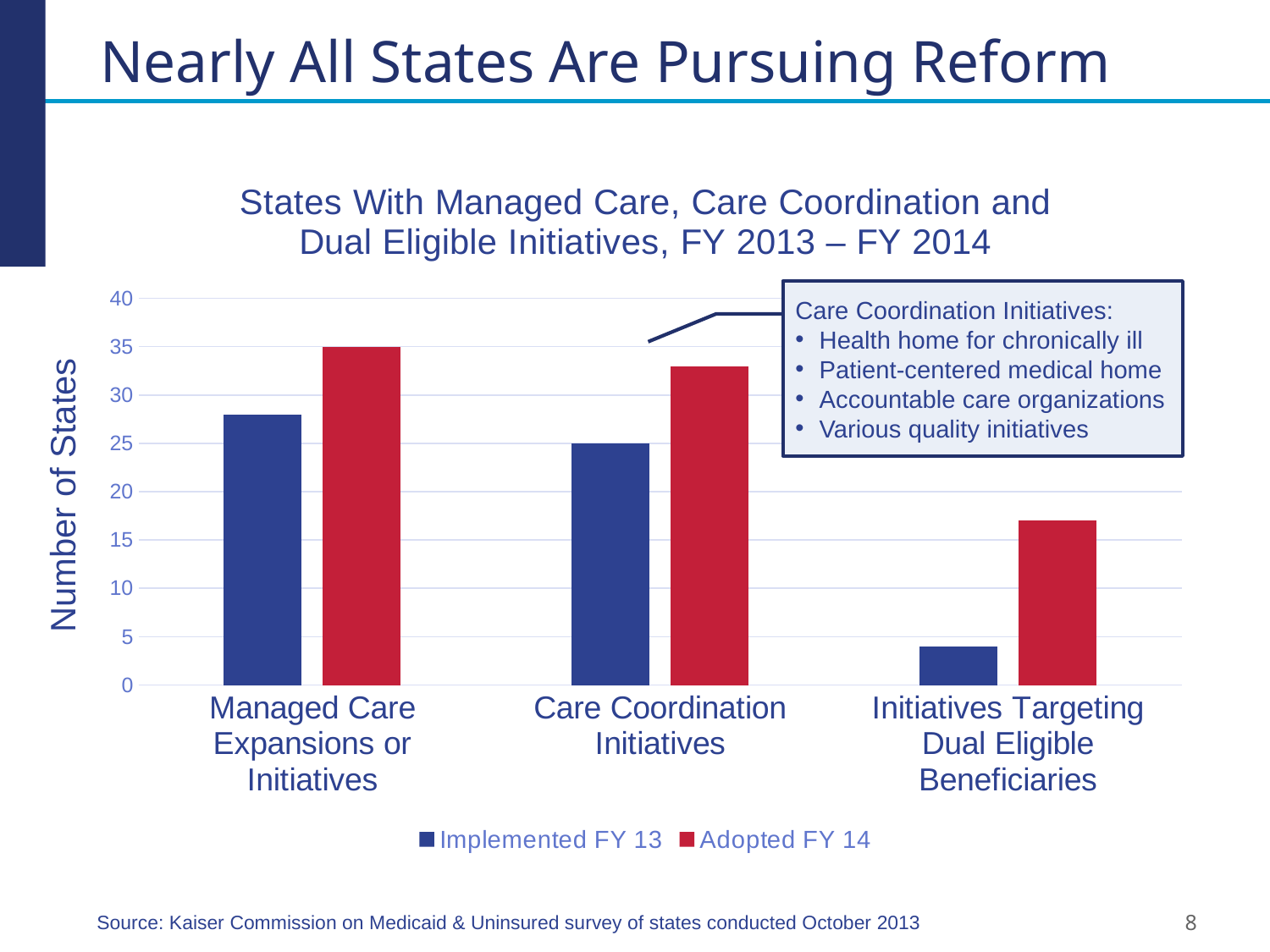
What is the label on the chart's vertical axis? Number of States Is the Implemented FY 13 value for Initiatives Targeting Dual Eligible Beneficiaries greater or less than 5? less How many categories are shown on the x axis of the chart? 3 How many series does the chart's legend list? 2 Is the Adopted FY 14 value for Initiatives Targeting Dual Eligible Beneficiaries greater or less than 20? less Is the Adopted FY 14 value for Care Coordination Initiatives greater or less than 30? greater For Managed Care Expansions or Initiatives, which is larger: Implemented FY 13 or Adopted FY 14? Adopted FY 14 What is the Adopted FY 14 value for Managed Care Expansions or Initiatives? 35 What kind of chart is shown on the slide? Bar chart Which category has the lowest Implemented FY 13 value? Initiatives Targeting Dual Eligible Beneficiaries Which category has the highest Adopted FY 14 value? Managed Care Expansions or Initiatives